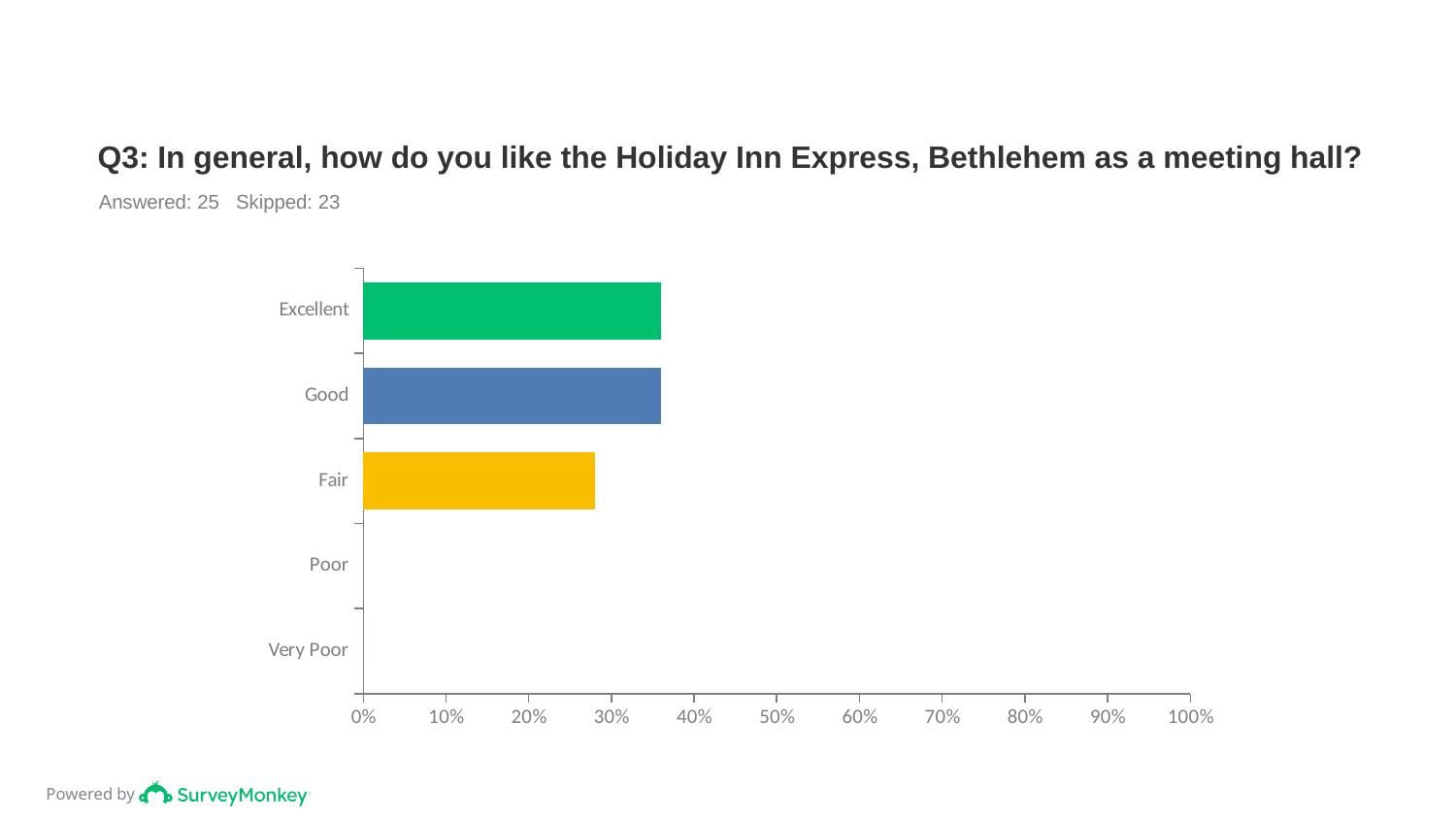
Is the value for Fair greater or less than 30%? less Which is larger, the value for Excellent or the value for Fair? Excellent Is the value for Excellent greater or less than 40%? less What colour is the bar for Fair? yellow Which is larger, the value for Fair or the value for Poor? Fair Is the value for Excellent greater or less than 30%? greater What is the title of the chart? Q3: In general, how do you like the Holiday Inn Express, Bethlehem as a meeting hall? How many response categories are shown on the chart? 5 What is the value for Very Poor? 0% What kind of chart is shown on the slide? bar chart